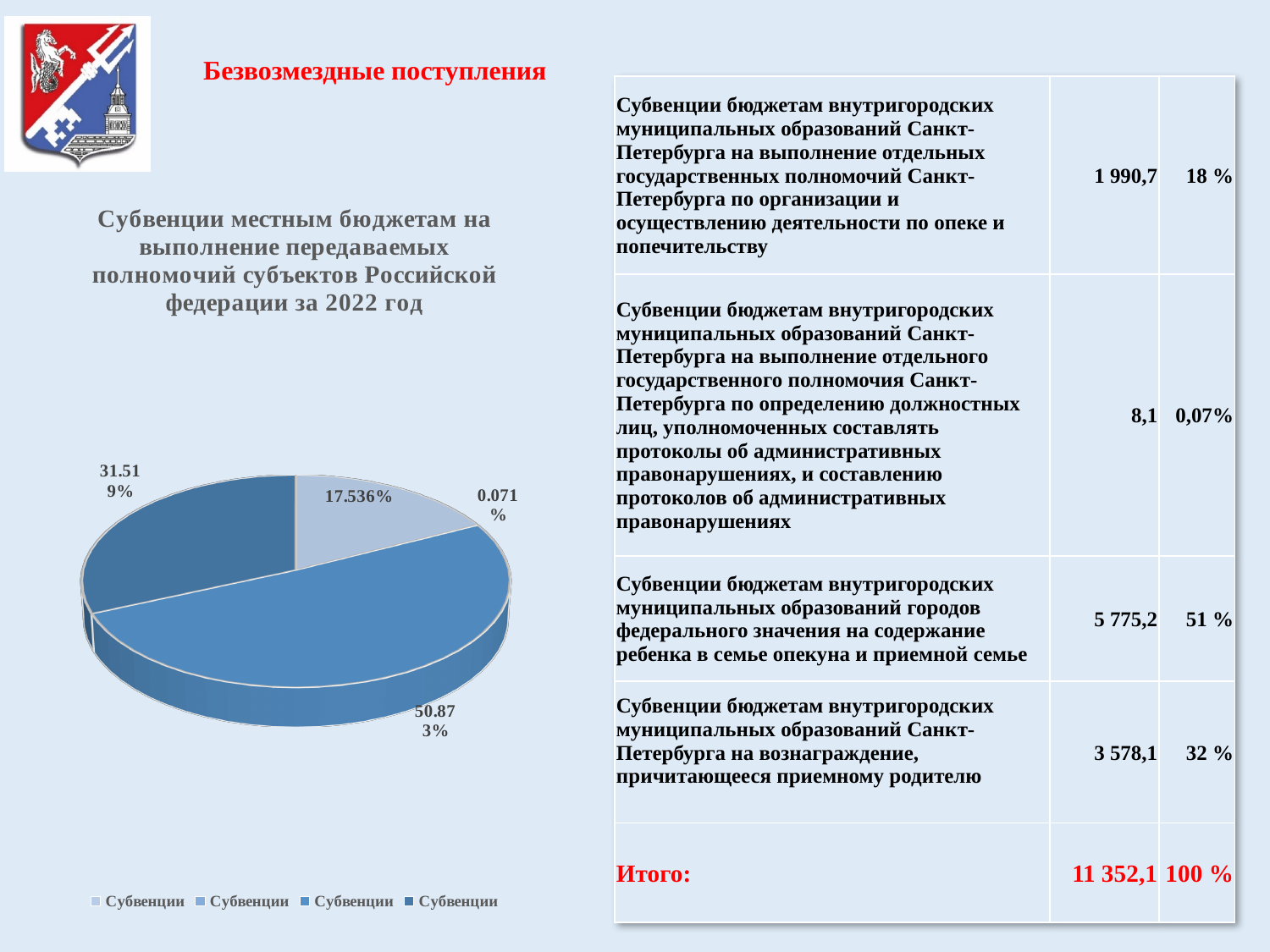
What is the title of the pie chart? Субвенции местным бюджетам на выполнение передаваемых полномочий субъектов Российской федерации за 2022 год How many slices does the pie chart have? 4 What kind of chart is shown on the left of the slide? pie chart What text is used for every entry in the pie chart's legend? Субвенции Is the slice labelled 17.536% larger or smaller than the slice labelled 31.519%? smaller What value is labelled on the lightest-coloured slice of the pie chart? 17.536% How many entries does the pie chart's legend list? 4 What is the value of the smallest slice in the pie chart? 0.071% Is the largest slice of the pie chart greater or less than 50%? greater What is the difference in percentage points between the slice labelled 50.873% and the slice labelled 31.519%? 19.354 What is the value of the largest slice in the pie chart? 50.873% What value is labelled on the darkest-coloured slice of the pie chart? 31.519%